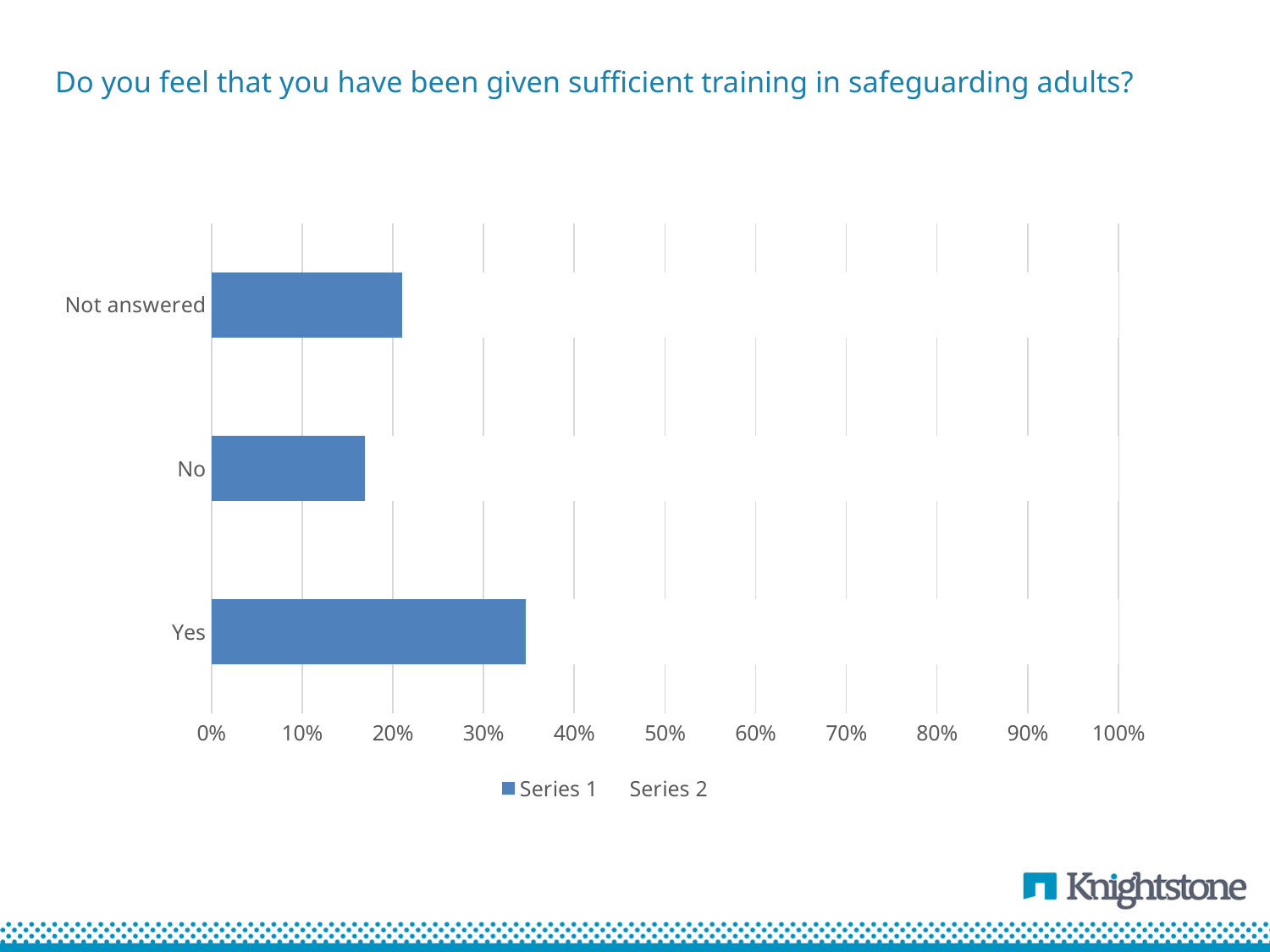
What question is the chart's title asking? Do you feel that you have been given sufficient training in safeguarding adults? Which is larger, the value for Yes or the value for Not answered? Yes Is the value for Not answered greater or less than 30%? less Is the value for Yes greater or less than 30%? greater How many series does the legend list? 2 Which is larger, the value for Not answered or the value for No? Not answered Which category has the lowest value? No What kind of chart is shown on the slide? bar chart Which category has the highest value? Yes How many categories are plotted on the chart? 3 Is the value for No greater or less than 20%? less